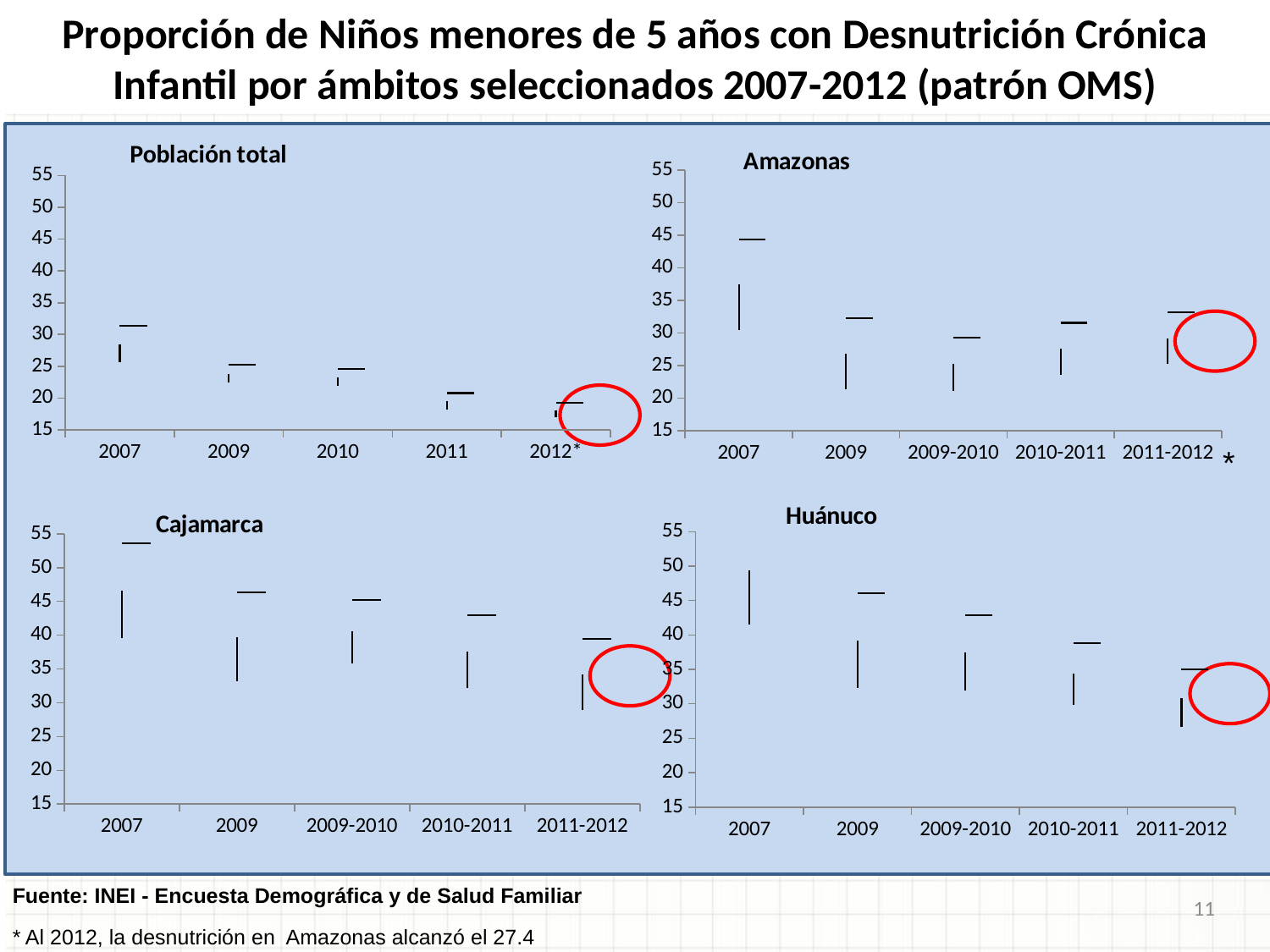
In the Población total chart, which period has the lowest value? 2012* In the Amazonas chart, which period has the highest value? 2007 How many charts are shown on the slide? 4 What is the title of the chart in the top-right position of the slide? Amazonas In the Huánuco chart, is the value for 2011-2012 greater or less than 40? less In the Población total chart, do the values rise or fall from 2007 to 2012*? fall In the Población total chart, how many time periods are shown on the x axis? 5 In the Cajamarca chart, do the values rise or fall from 2007 to 2011-2012? fall Which is larger: the 2007 value in the Cajamarca chart or the 2007 value in the Huánuco chart? Huánuco